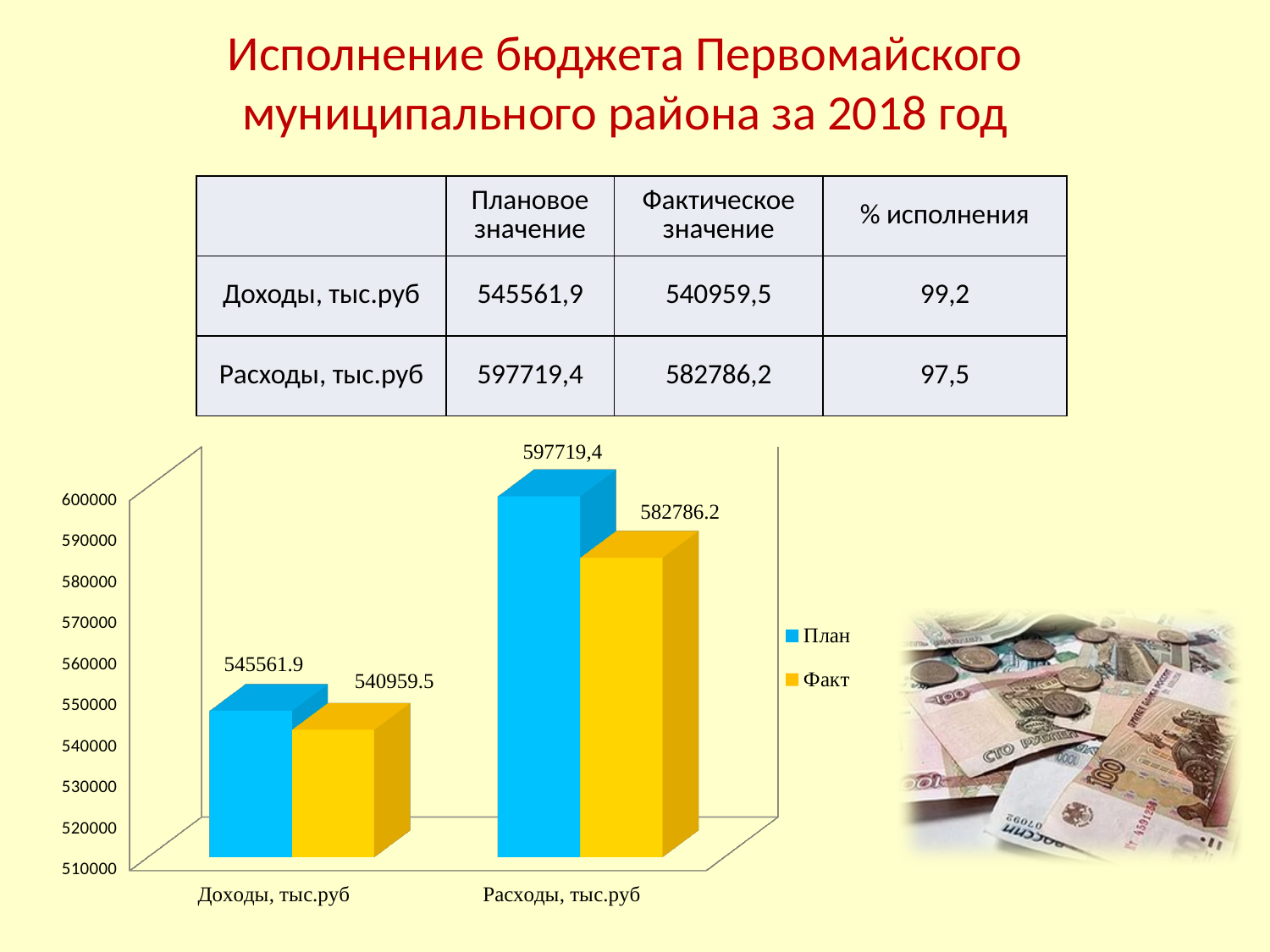
What is the План value for Расходы, тыс.руб in the chart? 597719,4 What is the Факт value for Доходы, тыс.руб in the chart? 540959.5 Which bar in the chart is the tallest? План for Расходы, тыс.руб Which is larger for Расходы, тыс.руб: the План value or the Факт value? План What type of chart is shown on the slide? bar chart How many categories are shown on the x axis of the chart? 2 What is the Факт value for Расходы, тыс.руб in the chart? 582786.2 How many series does the chart legend list? 2 Which bar in the chart is the lowest? Факт for Доходы, тыс.руб What is the difference between the План and Факт values for Доходы, тыс.руб? 4602.4 What is the План value for Доходы, тыс.руб in the chart? 545561.9 Which colour represents the Факт series in the chart? yellow